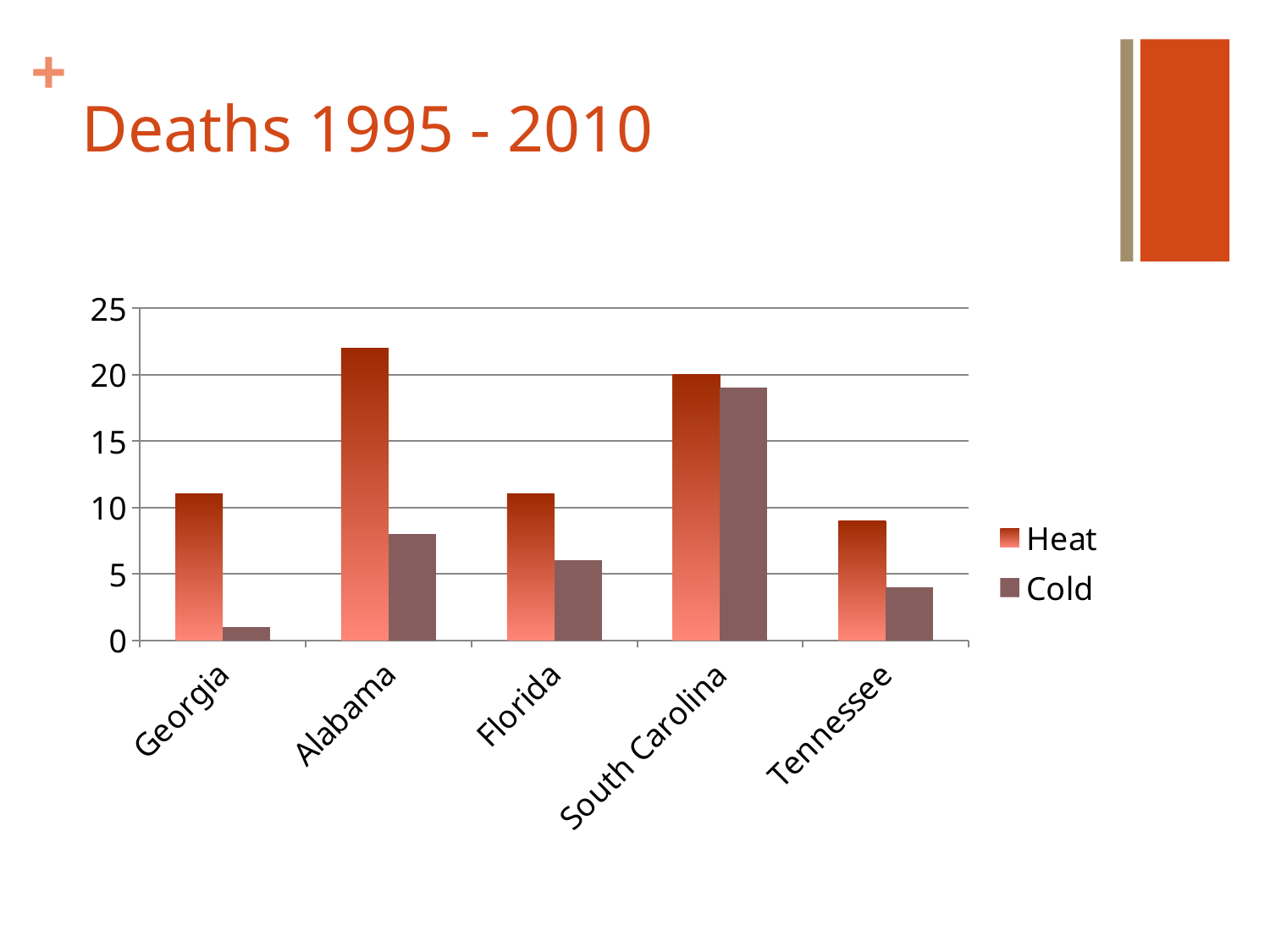
What are the two series named in the legend? Heat and Cold Is the Cold value for Georgia greater or less than 5? less How many states are shown on the x axis of the chart? 5 What kind of chart is shown on the slide? bar chart Is the Heat value for Tennessee greater or less than 10? less Is the Heat value for Alabama greater or less than 20? greater Which state has the lowest Cold value? Georgia Which is larger for Florida, the Heat value or the Cold value? Heat Which state has the highest Heat value? Alabama What is the title of the slide containing the chart? Deaths 1995 - 2010 How many series does the legend list? 2 Which state has the highest Cold value? South Carolina